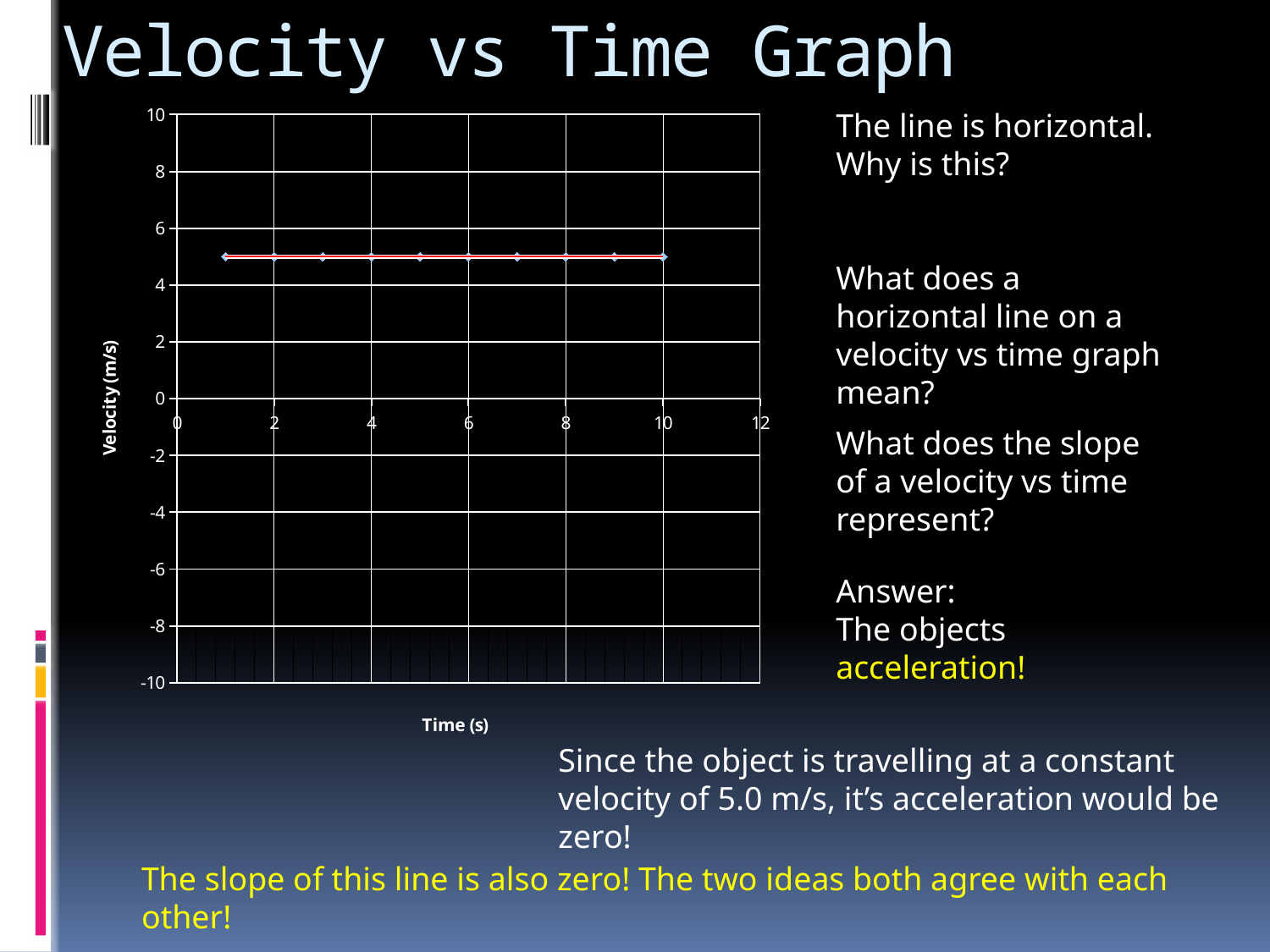
What is the lowest value shown on the vertical axis? -10 How many data points are plotted on the chart? 10 What is the largest tick value shown on the horizontal axis? 12 Is the velocity value at time 8 s greater or less than 6? less Is the velocity value at time 2 s greater or less than 4? greater What is the label on the vertical axis of the chart? Velocity (m/s) Do the plotted velocity values rise, fall, or stay constant as time increases? stay constant Is the velocity value at time 5 s greater or less than 0? greater What is the highest value shown on the vertical axis? 10 What is the label on the horizontal axis of the chart? Time (s) What kind of chart is shown on the slide? line chart